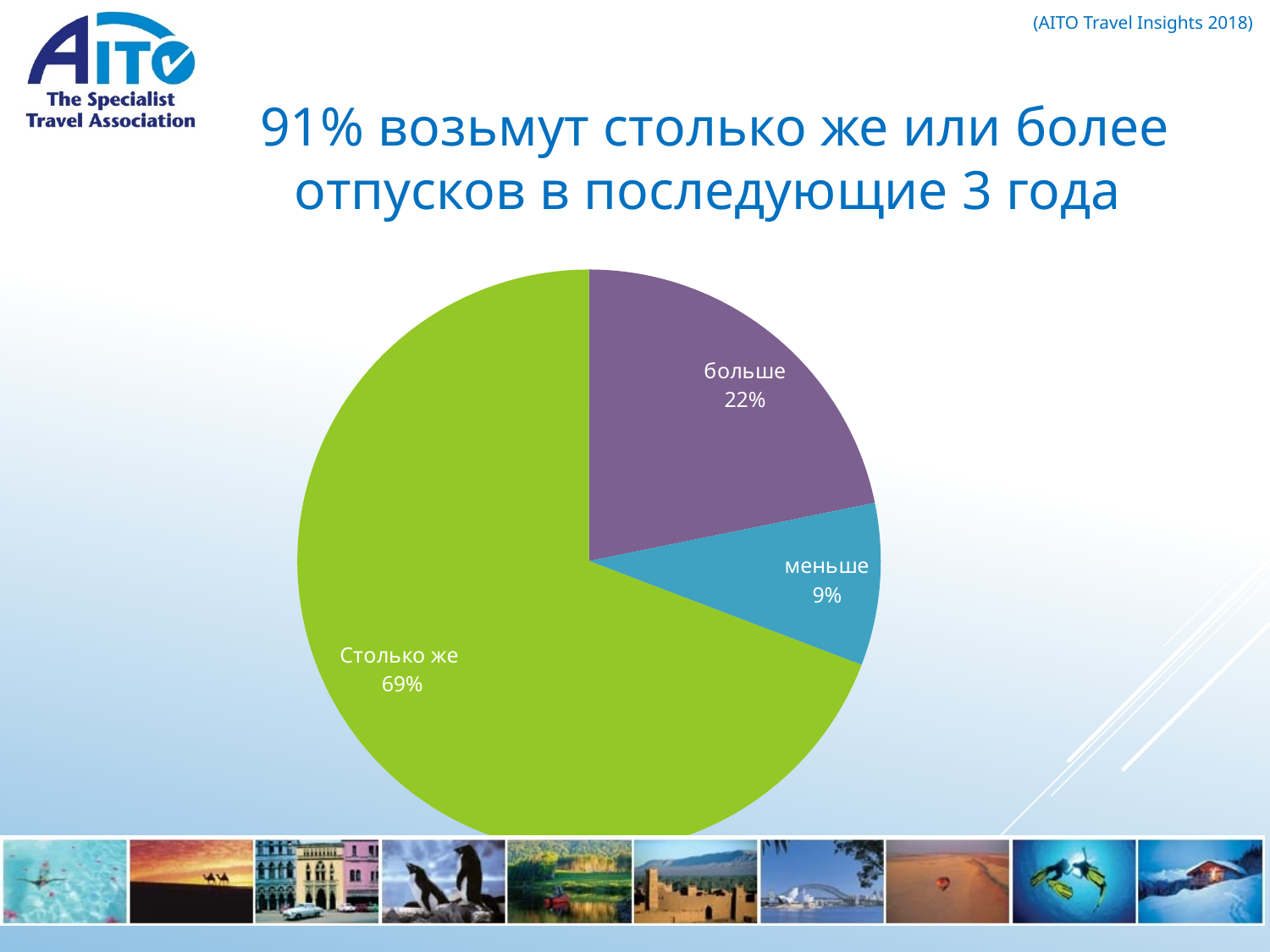
What is the difference in percentage points between the "Столько же" and "больше" slices? 47 What share of the pie does the "Столько же" slice represent? 69% What colour is the "Столько же" slice? green How many slices does the pie chart have? 3 What colour is the "больше" slice? purple Which is larger, the "больше" slice or the "меньше" slice? больше What kind of chart is shown on the slide? pie chart Which slice of the pie is the smallest? меньше Which slice of the pie is the largest? Столько же What share of the pie does the "больше" slice represent? 22% What is the difference in percentage points between the "больше" and "меньше" slices? 13 What share of the pie does the "меньше" slice represent? 9%